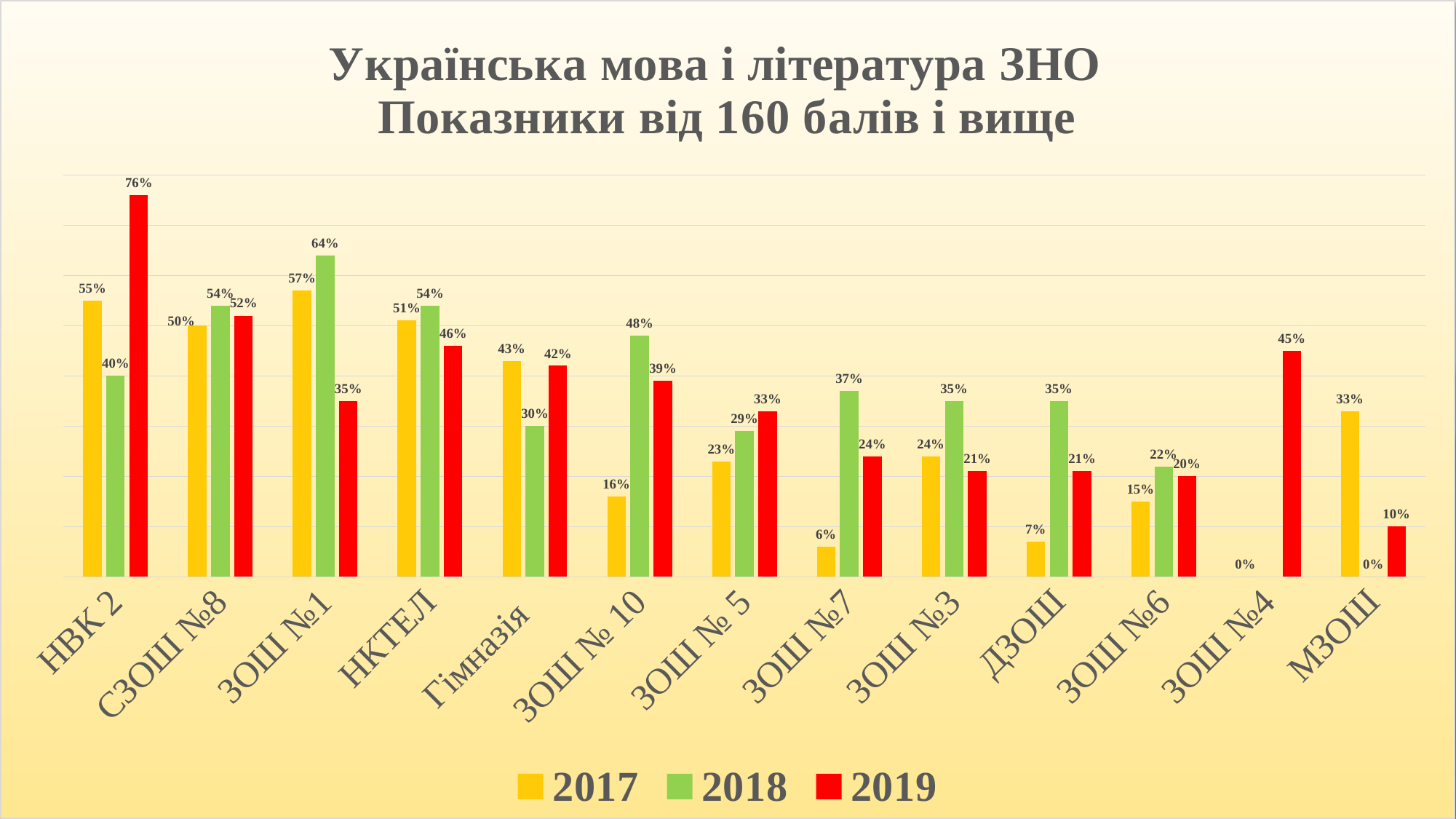
What is the 2017 value for ЗОШ №7? 6% What is the 2019 value for ЗОШ №4? 45% What is the 2018 value for ЗОШ №1? 64% What is the 2019 value for НВК 2? 76% What kind of chart is shown on the slide? bar chart What is the difference between the 2018 and 2019 values for ЗОШ №1? 29 percentage points How many schools (categories) are shown on the x axis? 13 Do the values for ЗОШ № 5 rise or fall from 2017 to 2019? rise For ЗОШ № 10, which is larger: the 2017 value or the 2018 value? 2018 Which school has the highest 2019 value? НВК 2 How many series does the legend list? 3 Which school has the lowest 2019 value? МЗОШ